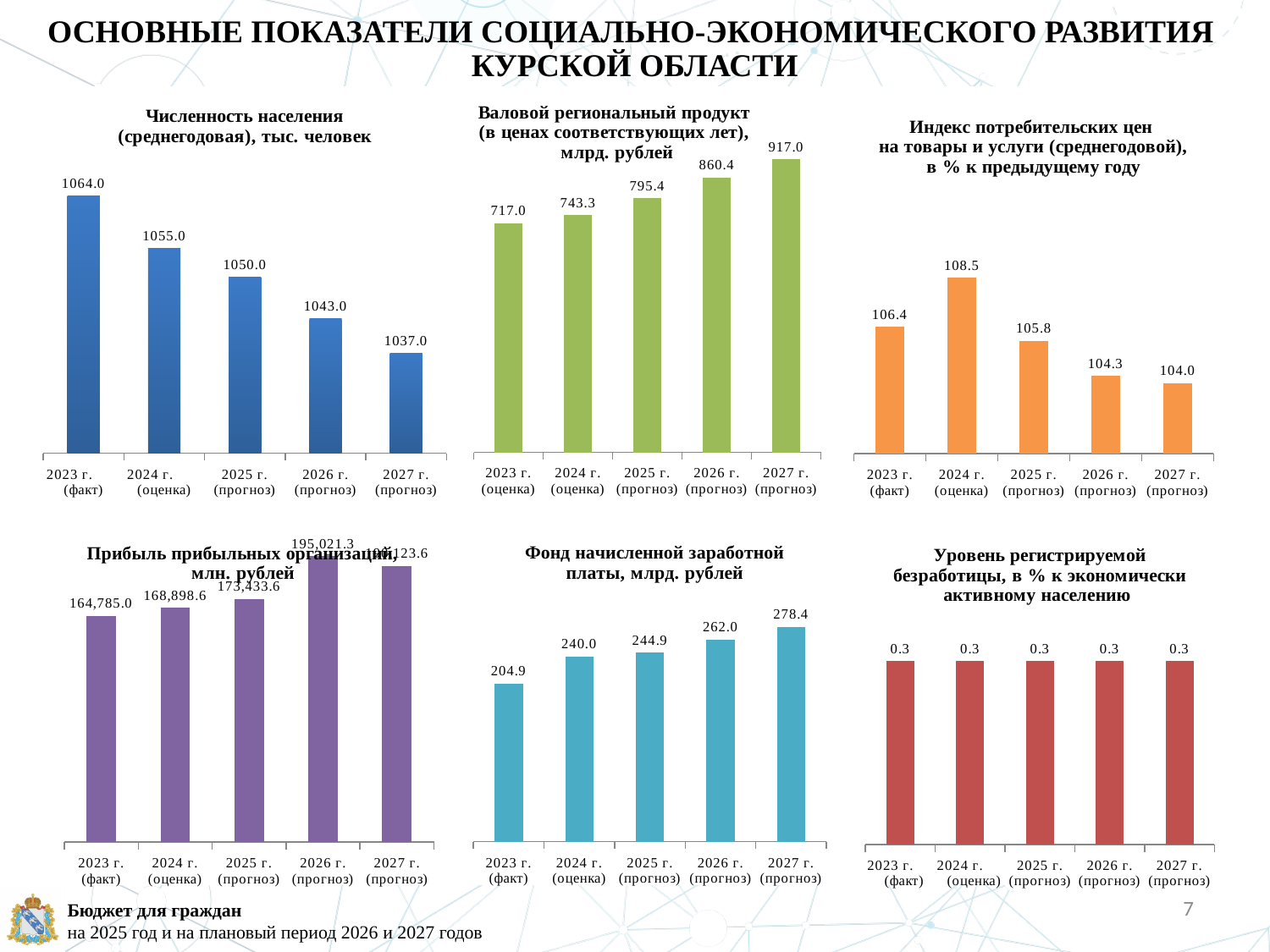
In the chart 'Валовой региональный продукт (в ценах соответствующих лет), млрд. рублей', which year has the highest value? 2027 г. (прогноз) In the chart 'Индекс потребительских цен на товары и услуги (среднегодовой), в % к предыдущему году', what is the value for 2024 г. (оценка)? 108.5 In the chart 'Численность населения (среднегодовая), тыс. человек', do the values rise or fall from 2023 to 2027? fall In the chart 'Фонд начисленной заработной платы, млрд. рублей', what is the value for 2026 г. (прогноз)? 262.0 In the chart 'Уровень регистрируемой безработицы, в % к экономически активному населению', what is the value for 2027 г. (прогноз)? 0.3 In the chart 'Прибыль прибыльных организаций, млн. рублей', what is the value for 2025 г. (прогноз)? 173,433.6 How many bars are in the chart 'Численность населения (среднегодовая), тыс. человек'? 5 In the chart 'Индекс потребительских цен на товары и услуги (среднегодовой), в % к предыдущему году', which year has the lowest value? 2027 г. (прогноз) In the chart 'Фонд начисленной заработной платы, млрд. рублей', which is larger: the value for 2024 г. (оценка) or 2023 г. (факт)? 2024 г. (оценка) In the chart 'Валовой региональный продукт (в ценах соответствующих лет), млрд. рублей', what is the difference between the 2027 г. (прогноз) and 2023 г. (оценка) values? 200.0 What type of chart is 'Валовой региональный продукт (в ценах соответствующих лет), млрд. рублей'? bar chart In the chart 'Численность населения (среднегодовая), тыс. человек', what is the value for 2023 г. (факт)? 1064.0